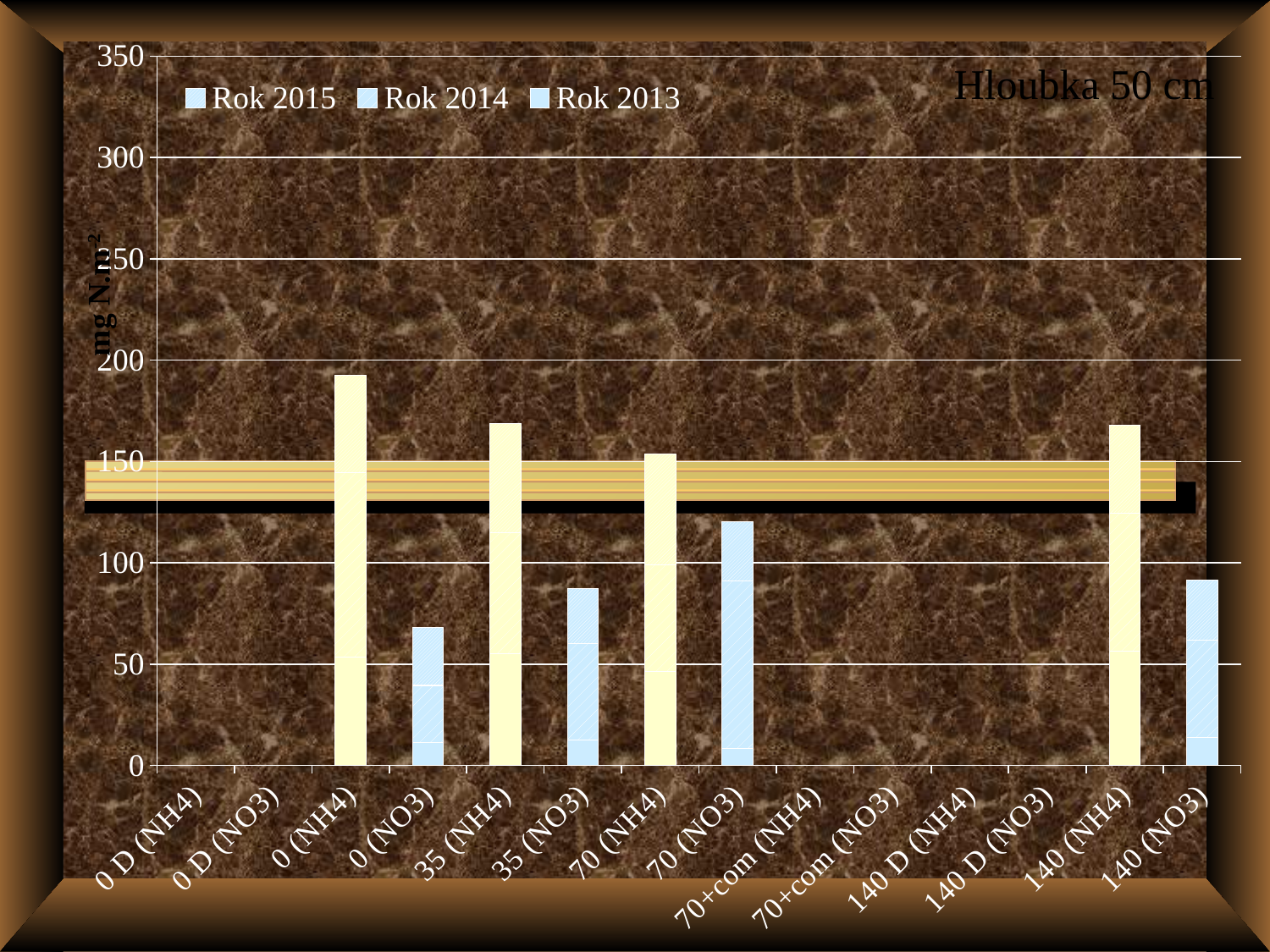
What kind of chart is shown on the slide? bar chart Which is larger, the value for 70 (NO3) or the value for 0 (NO3)? 70 (NO3) Is the value for 0 (NO3) greater or less than 100? less Which is larger, the value for 0 (NH4) or the value for 35 (NH4)? 0 (NH4) How many categories are shown on the x axis? 14 Which category has the tallest bar? 0 (NH4) Is the value for 70 (NO3) greater or less than 100? greater Is the value for 35 (NH4) greater or less than 150? greater How many series does the legend list? 3 What is the title shown in the top right of the chart? Hloubka 50 cm